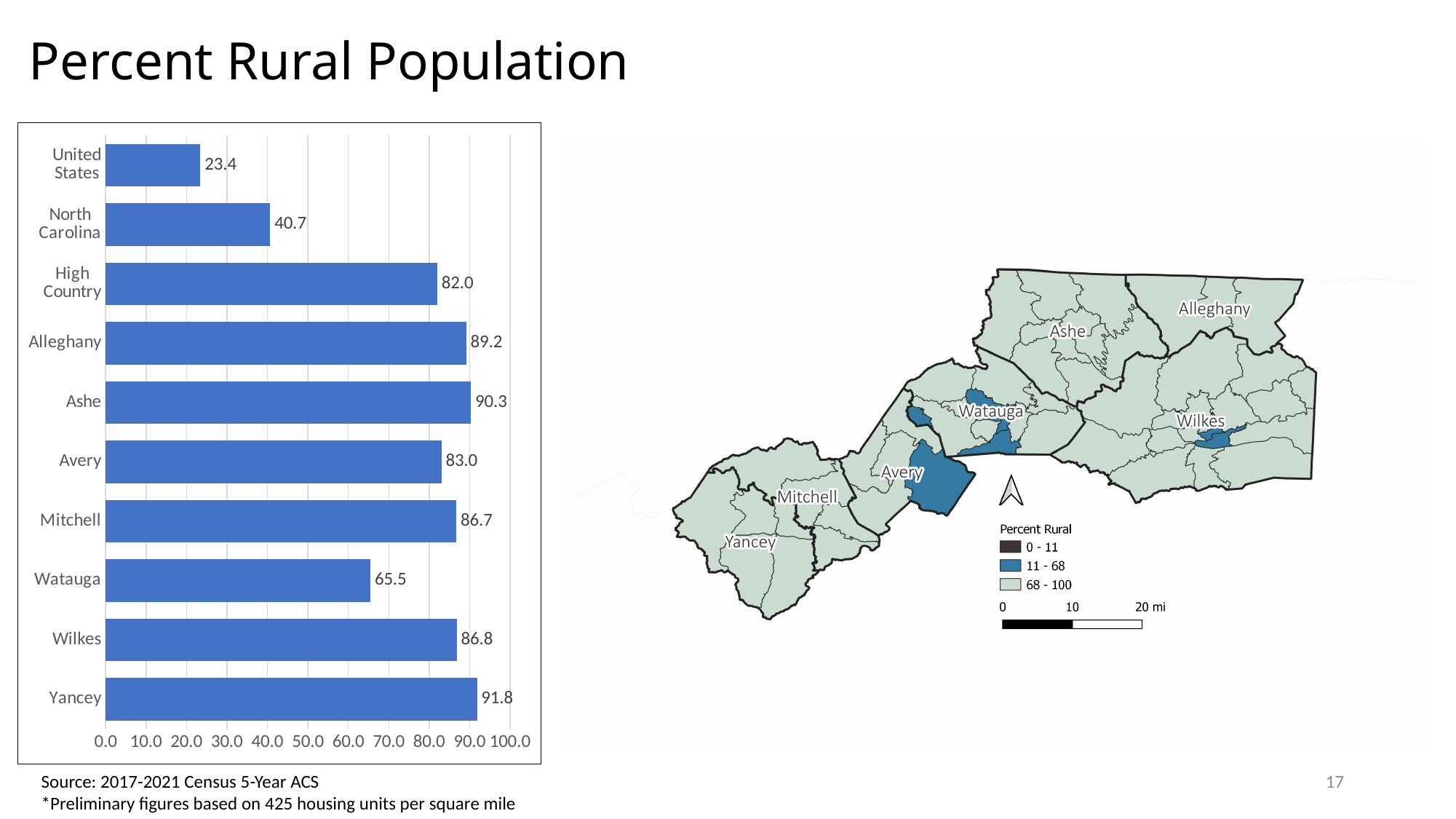
In the bar chart on the left, which category has the lowest value? United States In the bar chart on the left, what is the difference between the values for High Country and Watauga? 16.5 What kind of chart is shown on the left of the slide? bar chart In the bar chart on the left, what is the value for Yancey? 91.8 How many categories are shown in the bar chart on the left? 10 In the bar chart on the left, which category has the highest value? Yancey In the bar chart on the left, what is the difference between the values for Yancey and United States? 68.4 In the bar chart on the left, what is the value for Watauga? 65.5 In the bar chart on the left, which is larger, the value for Avery or the value for Watauga? Avery In the bar chart on the left, what is the value for North Carolina? 40.7 In the bar chart on the left, is the value for Ashe greater or less than 80.0? greater How many classes does the legend of the map on the right list under "Percent Rural"? 3